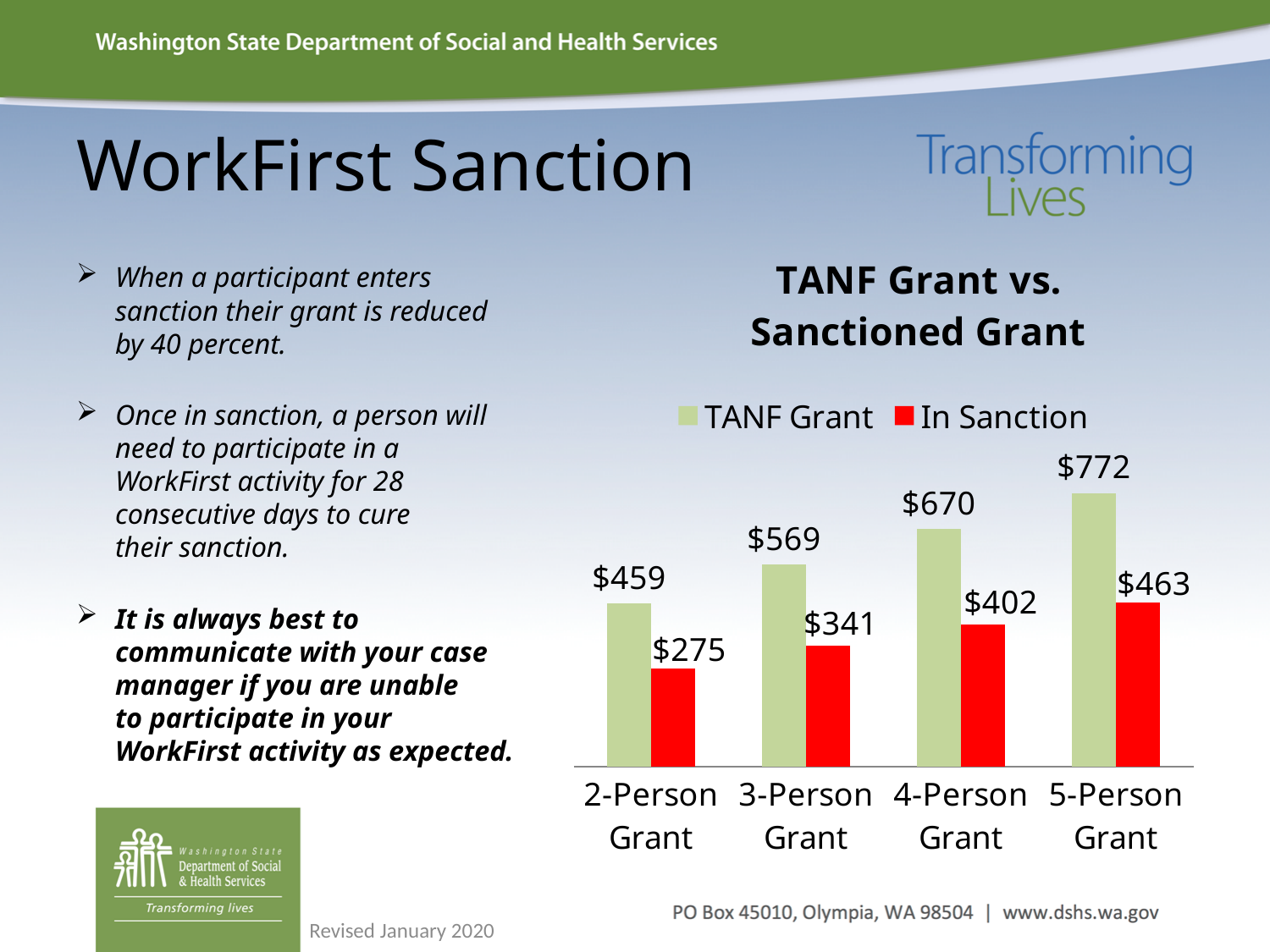
What is the difference between the TANF Grant and In Sanction values for a 4-Person Grant? $268 What is the TANF Grant value for a 3-Person Grant? $569 What is the title of the chart? TANF Grant vs. Sanctioned Grant Which is larger: the TANF Grant for a 2-Person Grant or the In Sanction value for a 5-Person Grant? In Sanction for 5-Person Grant How many series does the legend list? 2 How many household size categories are shown on the x axis? 4 Which household size has the highest TANF Grant value? 5-Person Grant What is the In Sanction value for a 5-Person Grant? $463 What kind of chart is shown on the slide? Bar chart What is the In Sanction value for a 2-Person Grant? $275 Which household size has the lowest In Sanction value? 2-Person Grant Do the TANF Grant values rise or fall as household size increases from 2-Person to 5-Person? Rise